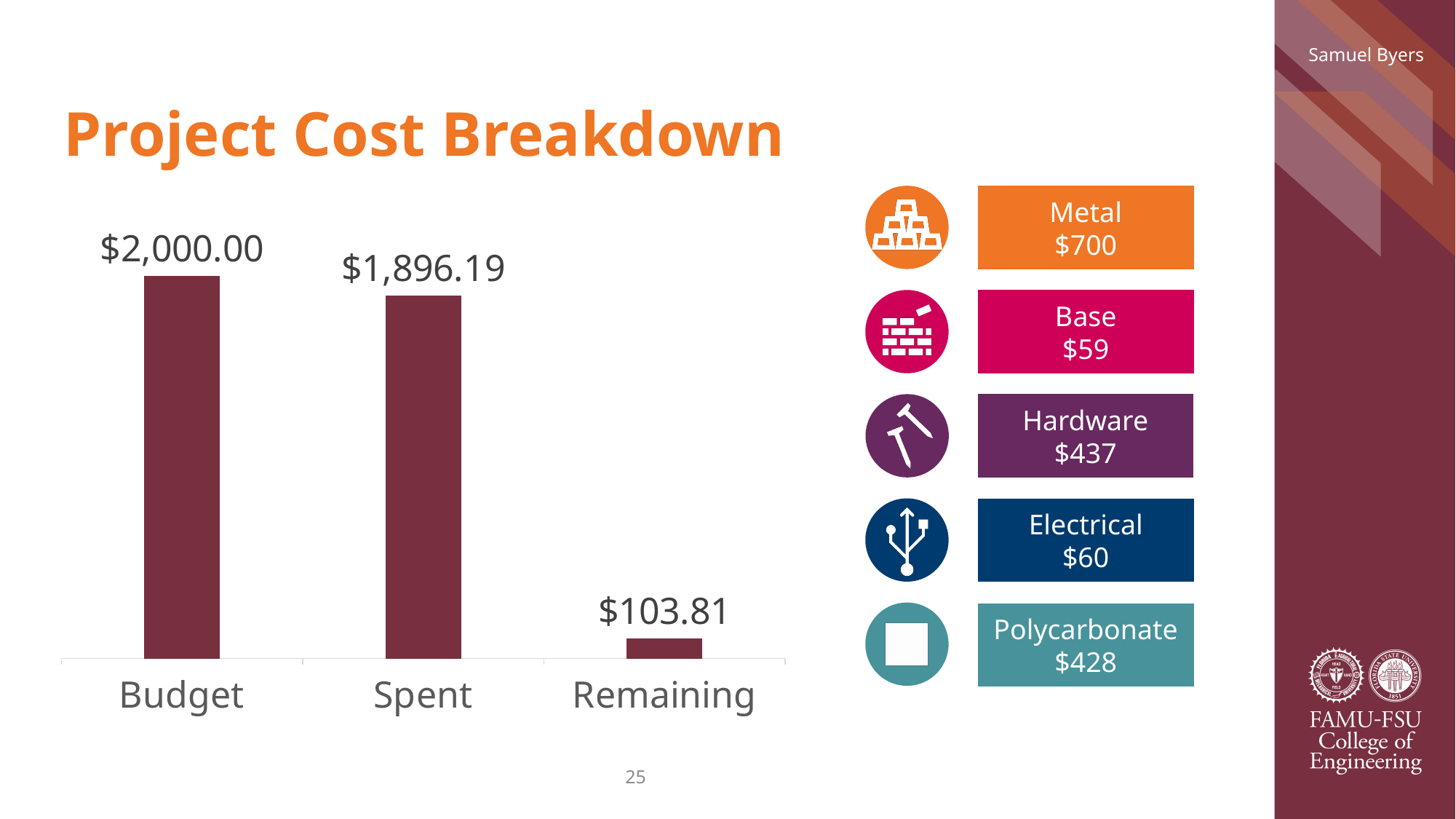
Do the bar values rise or fall from left to right across the categories? Fall What is the difference between the Spent and Remaining values? $1,792.38 Which is larger, the Spent value or the Remaining value? Spent How many categories are shown in the bar chart? 3 What kind of chart is shown on the slide? Bar chart What is the difference between the Budget and Spent values? $103.81 What is the value of the Remaining bar? $103.81 What is the value of the Spent bar? $1,896.19 What is the title of the slide containing the chart? Project Cost Breakdown What is the value of the Budget bar? $2,000.00 Which category has the highest value in the bar chart? Budget Which category has the lowest value in the bar chart? Remaining